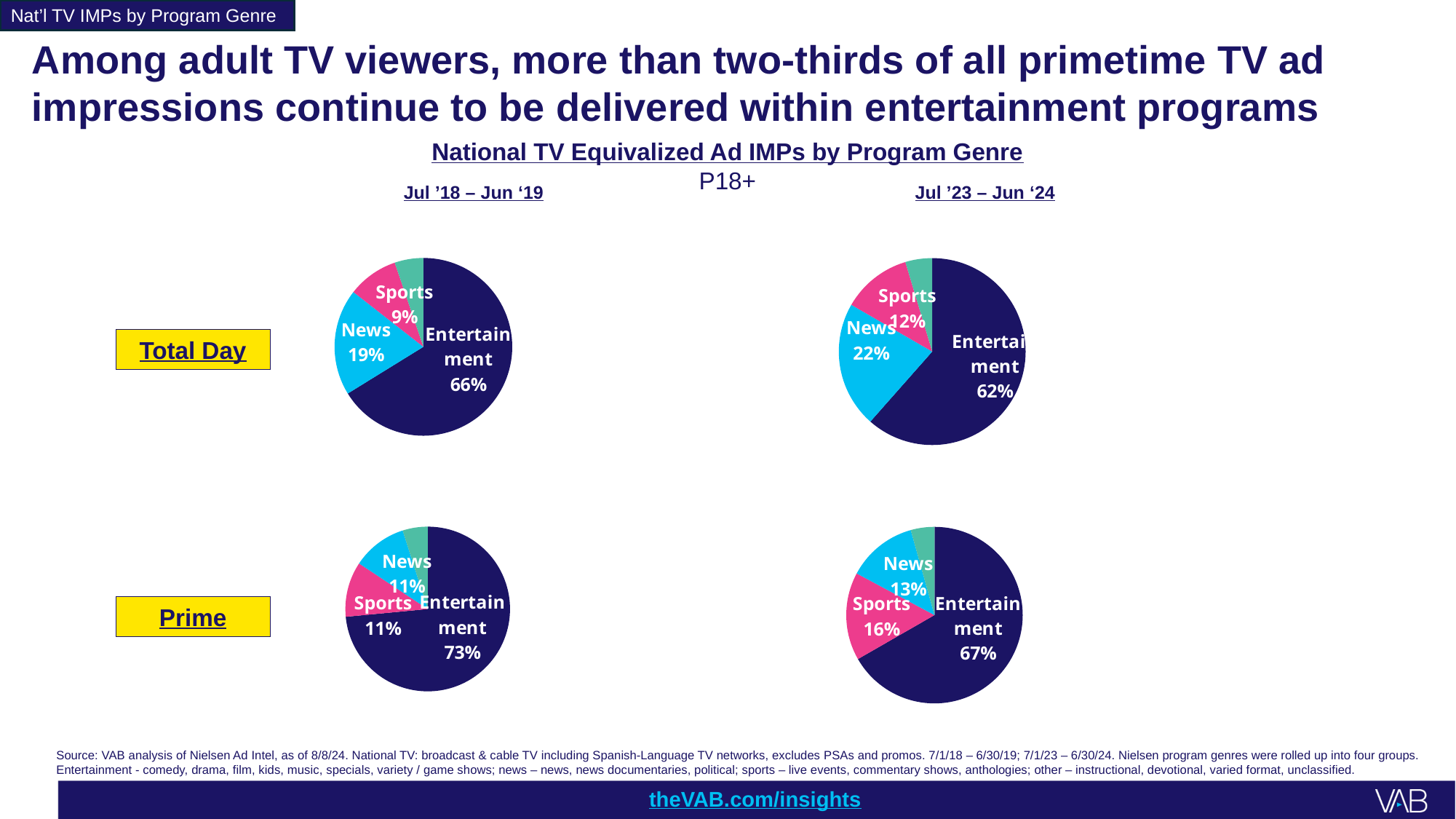
What type of chart is used to show the ad impressions by program genre on this slide? Pie chart In the Total Day pie chart for Jul '18 – Jun '19, which labeled genre has the smallest share? Sports What is the title of the chart group on this slide? National TV Equivalized Ad IMPs by Program Genre In the Prime pie chart for Jul '23 – Jun '24, which labeled genre has the largest share? Entertainment In the Prime pie chart for Jul '23 – Jun '24, what is the difference between the Entertainment share and the Sports share? 51 percentage points In the Total Day pie chart for Jul '23 – Jun '24, what is the share for News? 22% In the Total Day pie chart for Jul '18 – Jun '19, what share of ad impressions is delivered within Entertainment programs? 66% How much did the Entertainment share in the Total Day chart change from Jul '18 – Jun '19 (66%) to Jul '23 – Jun '24 (62%)? 4 percentage points lower Which is larger: the Sports share in the Total Day chart for Jul '18 – Jun '19 or the Sports share in the Total Day chart for Jul '23 – Jun '24? Jul '23 – Jun '24 (12%) In the Prime pie chart for Jul '23 – Jun '24, what is the share for Sports? 16% In the Prime pie chart for Jul '18 – Jun '19, what is the share for Entertainment? 73% In the Prime pie chart for Jul '18 – Jun '19, is the News share or the Sports share larger? They are equal (11% each)